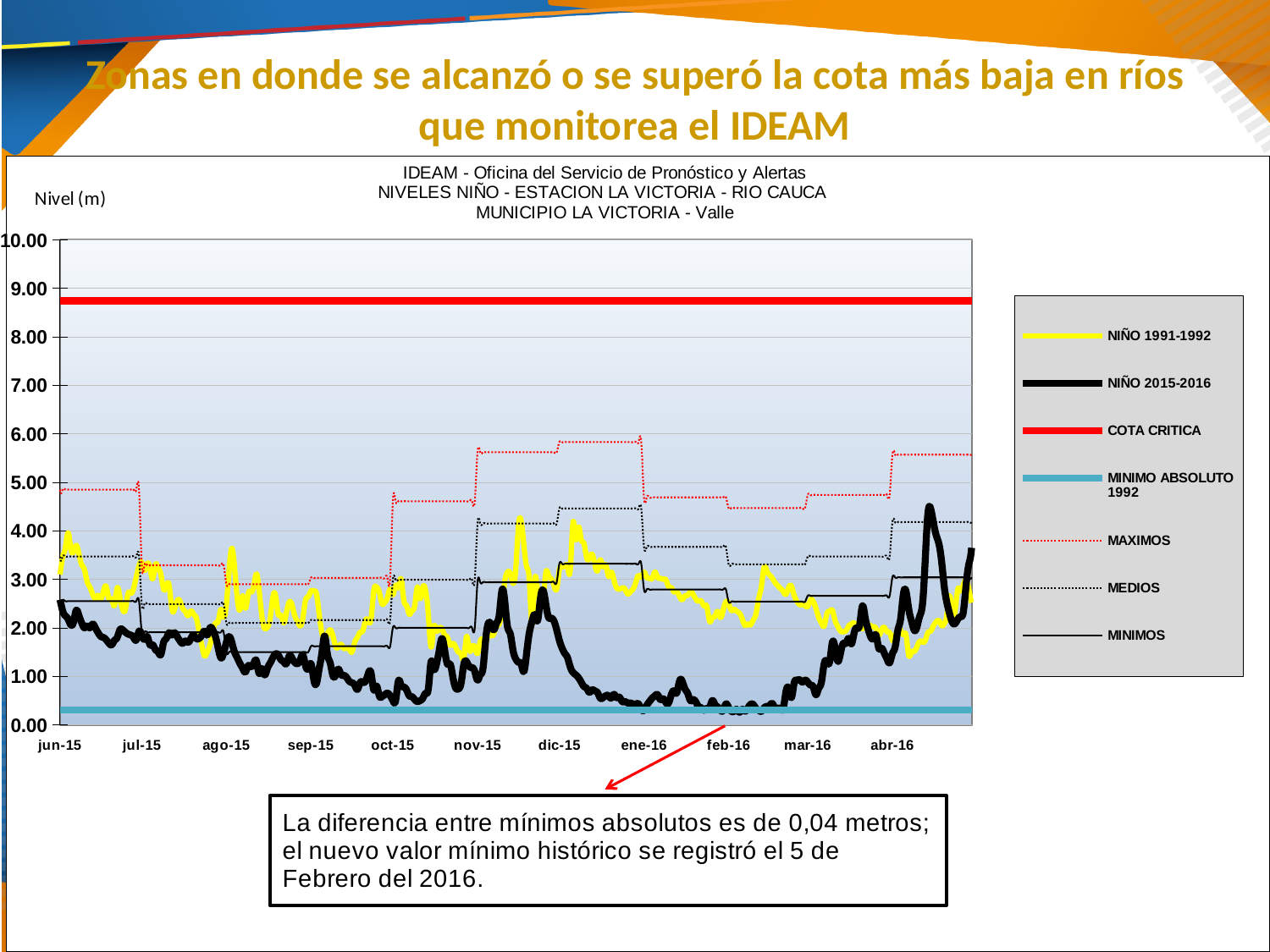
Which series lies lowest on the chart across the whole period? MINIMO ABSOLUTO 1992 Is the value of the MINIMO ABSOLUTO 1992 line greater or less than 1.00? less Is the value of the COTA CRITICA line greater or less than 9.00? less Does the NIÑO 2015-2016 line rise or fall from jun-15 to feb-16? fall Which series lies highest on the chart across the whole period? COTA CRITICA Is the MAXIMOS level around dic-15 greater or less than 5.00? greater How many series does the legend list? 7 What label is shown on the y axis of the chart? Nivel (m) What kind of chart is shown on the slide? line chart How many month labels are shown on the x axis? 11